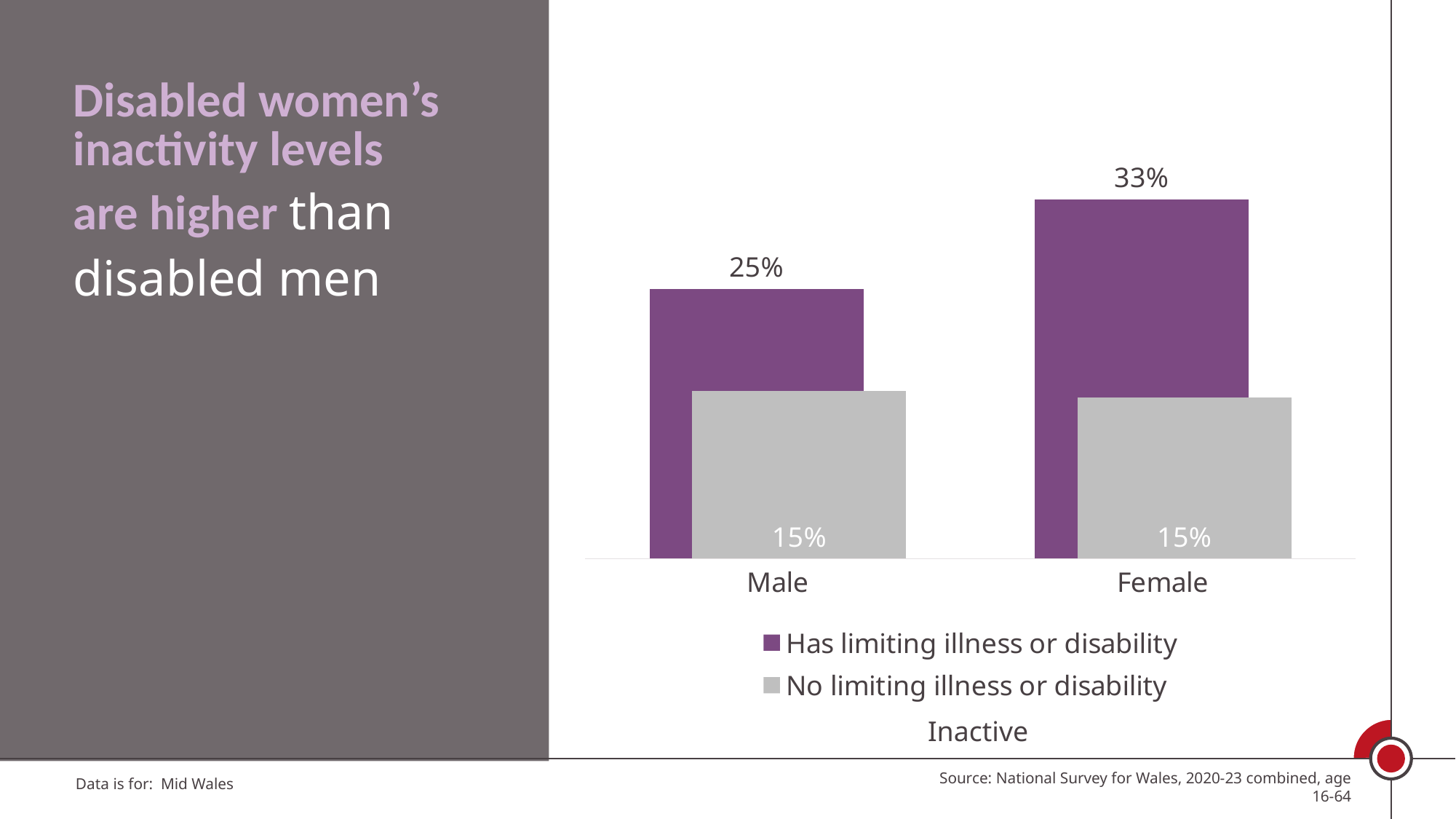
What is the inactivity value for Female with no limiting illness or disability? 15% What is the inactivity value for Male with no limiting illness or disability? 15% How many categories are shown on the x axis? 2 For Male, what is the difference between 'Has limiting illness or disability' and 'No limiting illness or disability'? 10% Which category has the highest value for 'Has limiting illness or disability'? Female Which is larger: the Male value for 'Has limiting illness or disability' or the Female value for 'Has limiting illness or disability'? Female What is the difference between the Female and Male values for 'Has limiting illness or disability'? 8% How many series does the legend list? 2 For Female, what is the difference between 'Has limiting illness or disability' and 'No limiting illness or disability'? 18% What is the inactivity value for Female with a limiting illness or disability? 33% What is the inactivity value for Male with a limiting illness or disability? 25% What kind of chart is shown on the slide? Bar chart